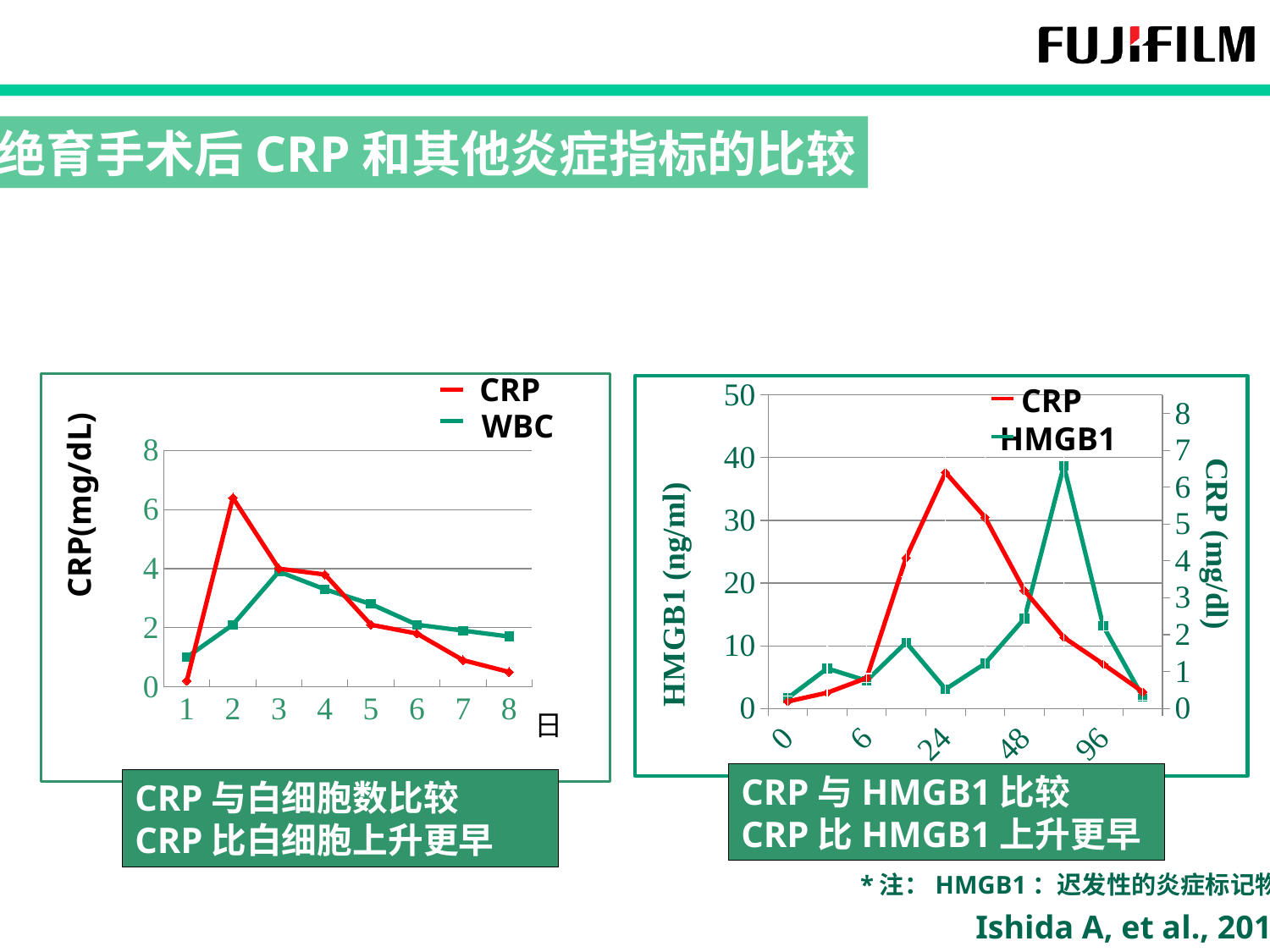
In the left chart (CRP vs WBC), how many series does the legend list? 2 In the left chart (CRP vs WBC), is the CRP value on day 2 greater or less than 6? greater In the right chart (CRP vs HMGB1), how many series does the legend list? 2 In the left chart (CRP vs WBC), on which day does CRP reach its highest value? 2 In the left chart (CRP vs WBC), on which day does WBC reach its highest value? 3 In the left chart (CRP vs WBC), is the CRP value on day 1 greater or less than 2? less In the right chart (CRP vs HMGB1), is the HMGB1 value at 0 greater or less than 10 ng/ml? less In the left chart (CRP vs WBC), what kind of chart is shown? line chart In the left chart (CRP vs WBC), does CRP rise or fall from day 2 to day 8? fall In the right chart (CRP vs HMGB1), what is the label of the left y axis? HMGB1 (ng/ml) In the left chart (CRP vs WBC), how many days are plotted on the x axis? 8 In the left chart (CRP vs WBC), which is larger on day 2, CRP or WBC? CRP